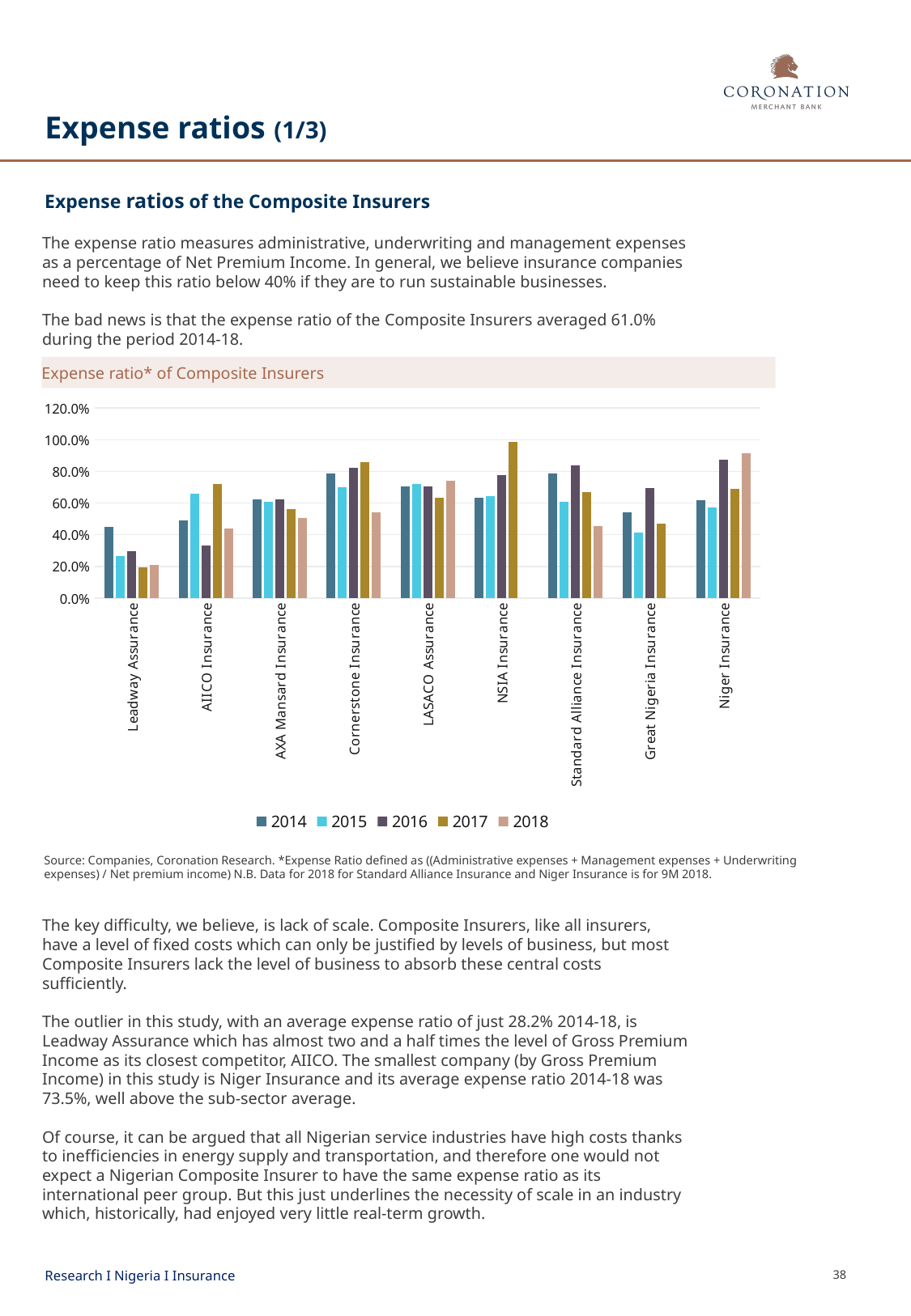
Which is larger: the 2016 expense ratio for Cornerstone Insurance or for Leadway Assurance? Cornerstone Insurance Is the 2018 expense ratio for Niger Insurance greater or less than 80.0%? greater Which insurer has the lowest 2017 expense ratio in the chart? Leadway Assurance Is the 2017 expense ratio for NSIA Insurance greater or less than 80.0%? greater How many insurers are shown on the x axis of the expense ratio chart? 9 How many years (series) does the legend of the expense ratio chart list? 5 Which insurer has the highest 2017 expense ratio in the chart? NSIA Insurance Which two insurers have no 2018 bar in the expense ratio chart? NSIA Insurance and Great Nigeria Insurance Is the 2017 expense ratio for Leadway Assurance greater or less than 40.0%? less What kind of chart is used to show the expense ratio of Composite Insurers? Bar chart Does the expense ratio for NSIA Insurance rise or fall from 2014 to 2017? Rises Which years are listed in the legend of the expense ratio chart? 2014, 2015, 2016, 2017, 2018